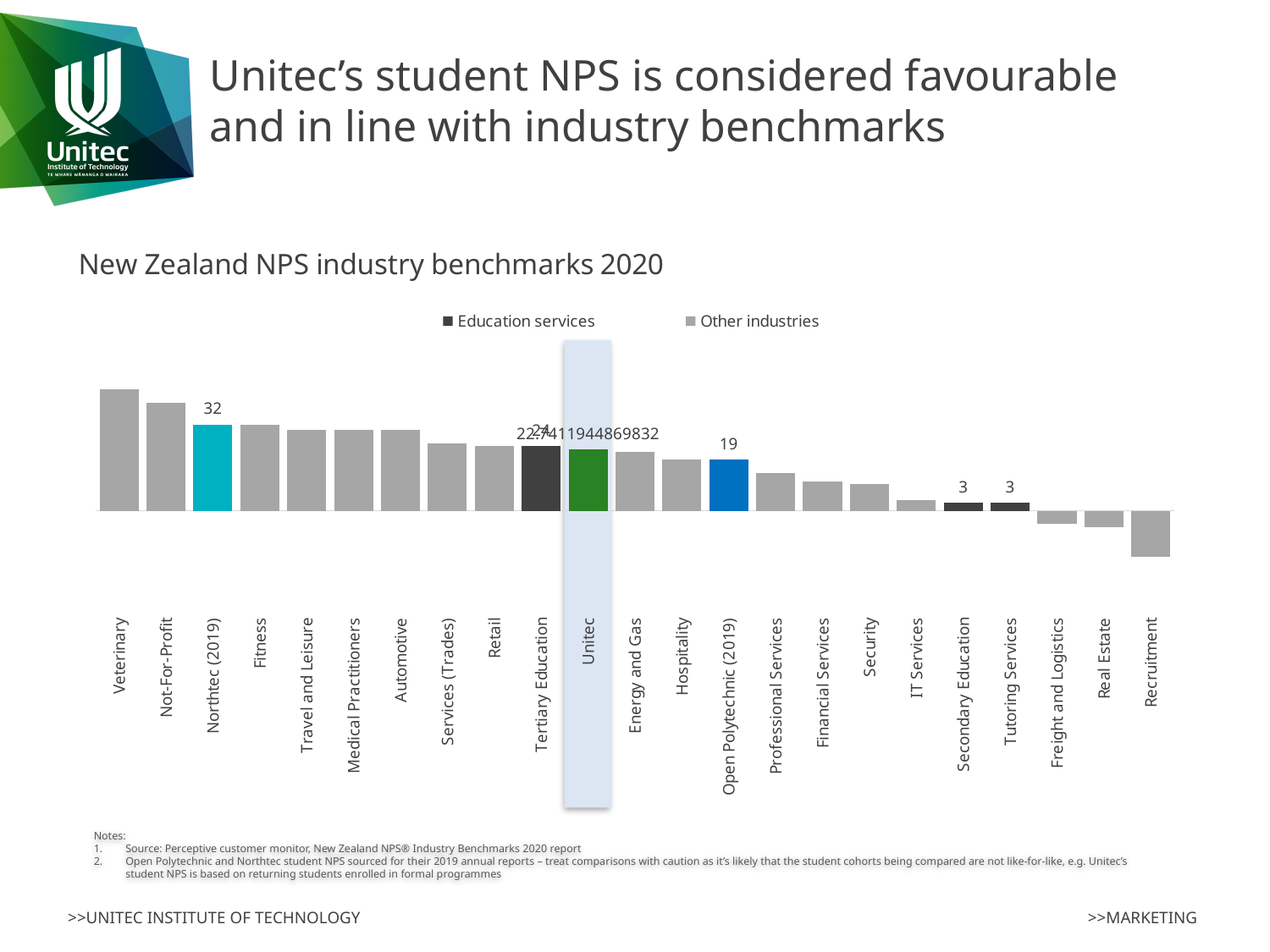
What is the value for Secondary Education? 3 What is the difference between the values for Northtec (2019) and Open Polytechnic (2019)? 13 Do the values generally rise or fall from left to right along the x axis? Fall What is the title of the chart? New Zealand NPS industry benchmarks 2020 Which category has the highest value? Veterinary What is the value for Northtec (2019)? 32 How many series does the legend list? 2 Which category has the lowest value? Recruitment What kind of chart is shown on the slide? Bar chart What are the two legend entries? Education services and Other industries What is the value for Open Polytechnic (2019)? 19 How many categories are plotted on the chart? 23